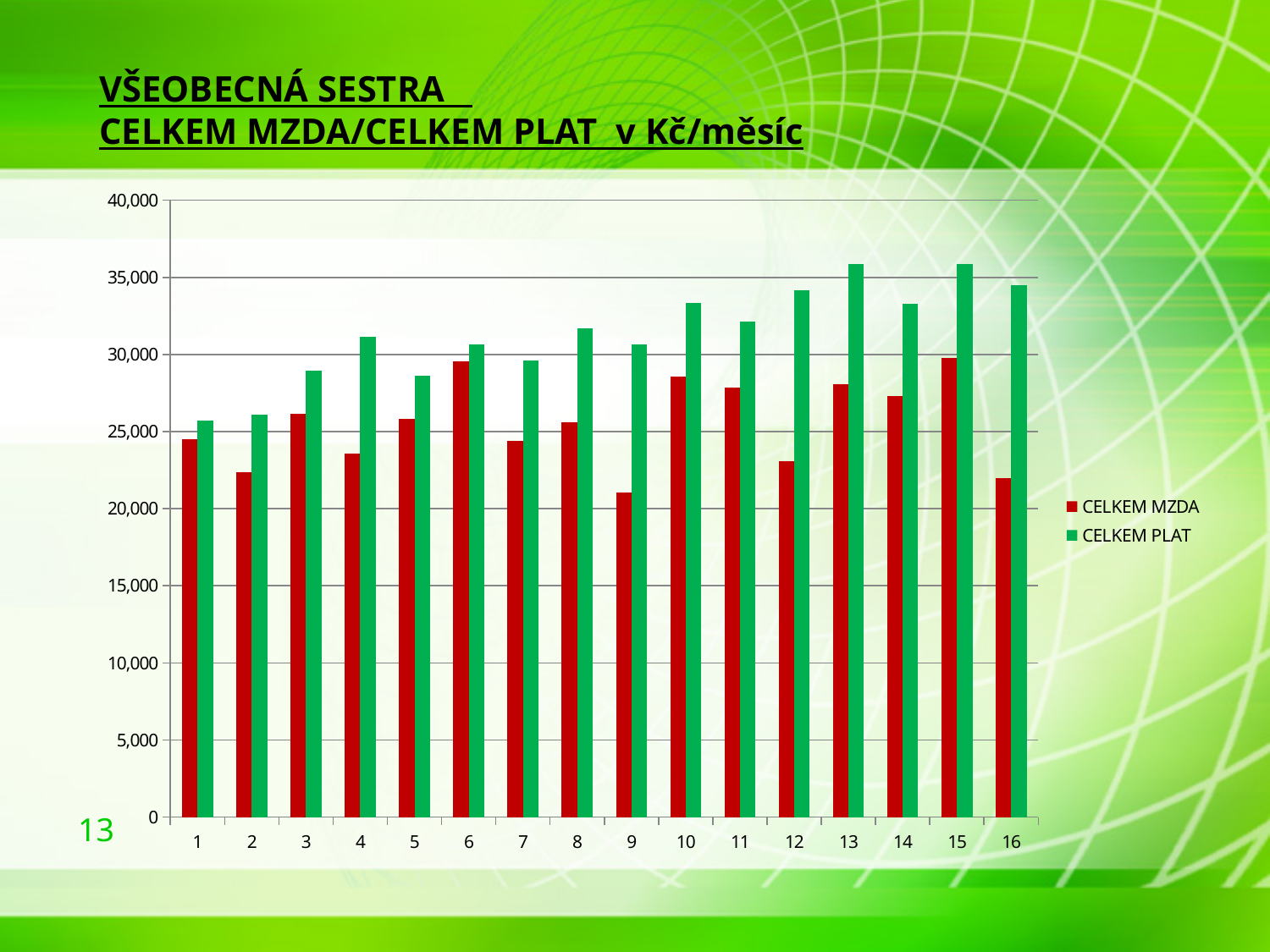
Is the CELKEM MZDA value for category 9 greater or less than 25,000? less Which series is shown in green? CELKEM PLAT What kind of chart is shown on the slide? bar chart How many categories are shown along the x axis? 16 Is the CELKEM PLAT value for category 12 greater or less than 30,000? greater How many series does the legend list? 2 Is the CELKEM MZDA value for category 2 greater or less than 20,000? greater For category 9, which is larger: CELKEM MZDA or CELKEM PLAT? CELKEM PLAT What are the two legend entries of the chart? CELKEM MZDA, CELKEM PLAT Which is larger: the CELKEM MZDA value for category 6 or for category 9? category 6